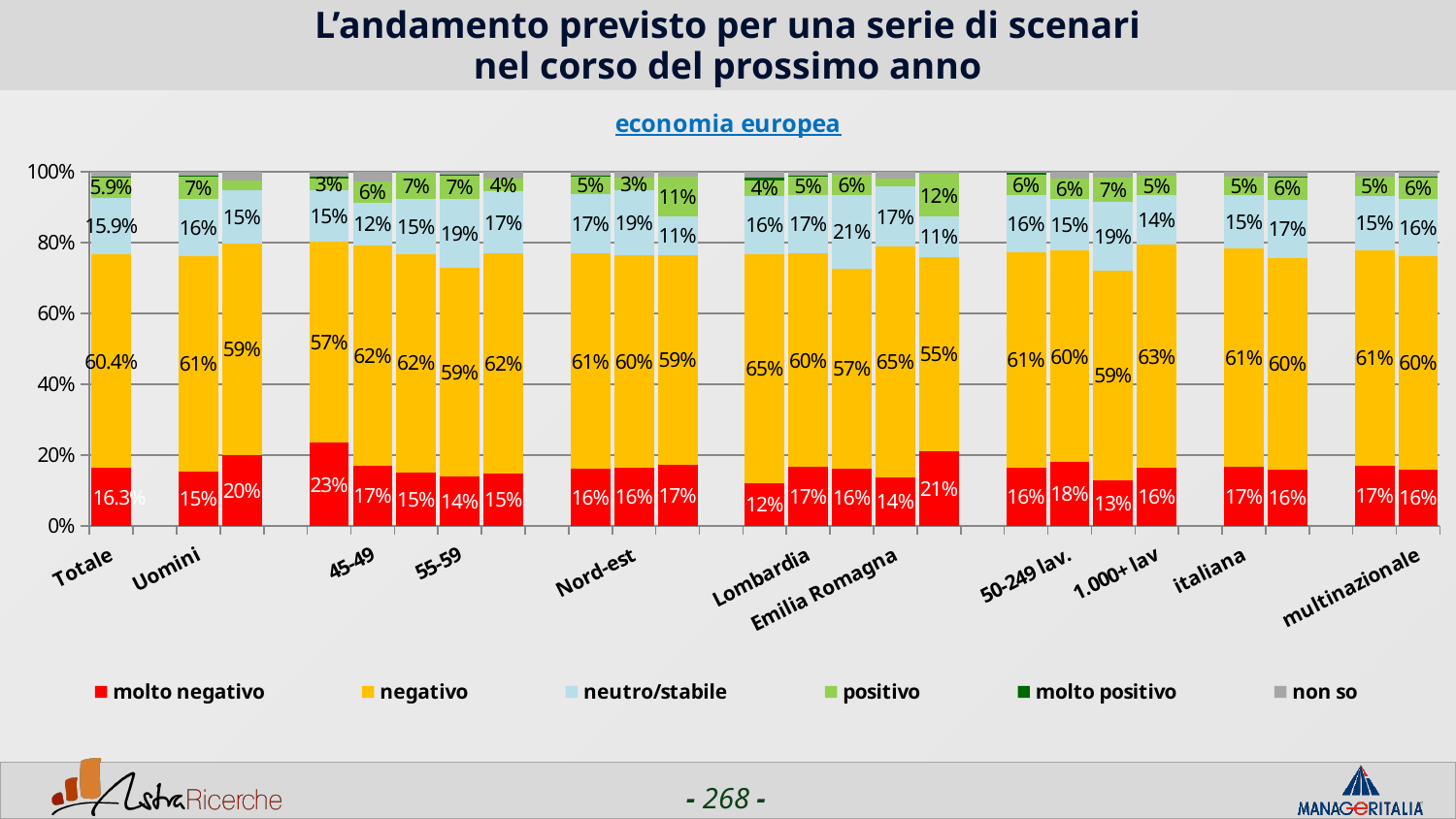
What kind of chart is shown on the slide? stacked bar chart What is the 'molto negativo' value for Totale? 16.3% What is the 'negativo' value for the 45-49 group? 62% What is the 'negativo' value for Totale? 60.4% What subtitle appears above the chart? economia europea What is the 'positivo' value for Uomini? 7% What is the 'molto negativo' value for Uomini? 15% What is the difference between the 'molto negativo' value for Totale and for Uomini? 1.3 percentage points Which colour represents 'molto negativo' in the legend? red What is the 'neutro/stabile' value for Totale? 15.9% Which has the larger 'negativo' value, Totale or Uomini? Uomini How many series does the legend list? 6